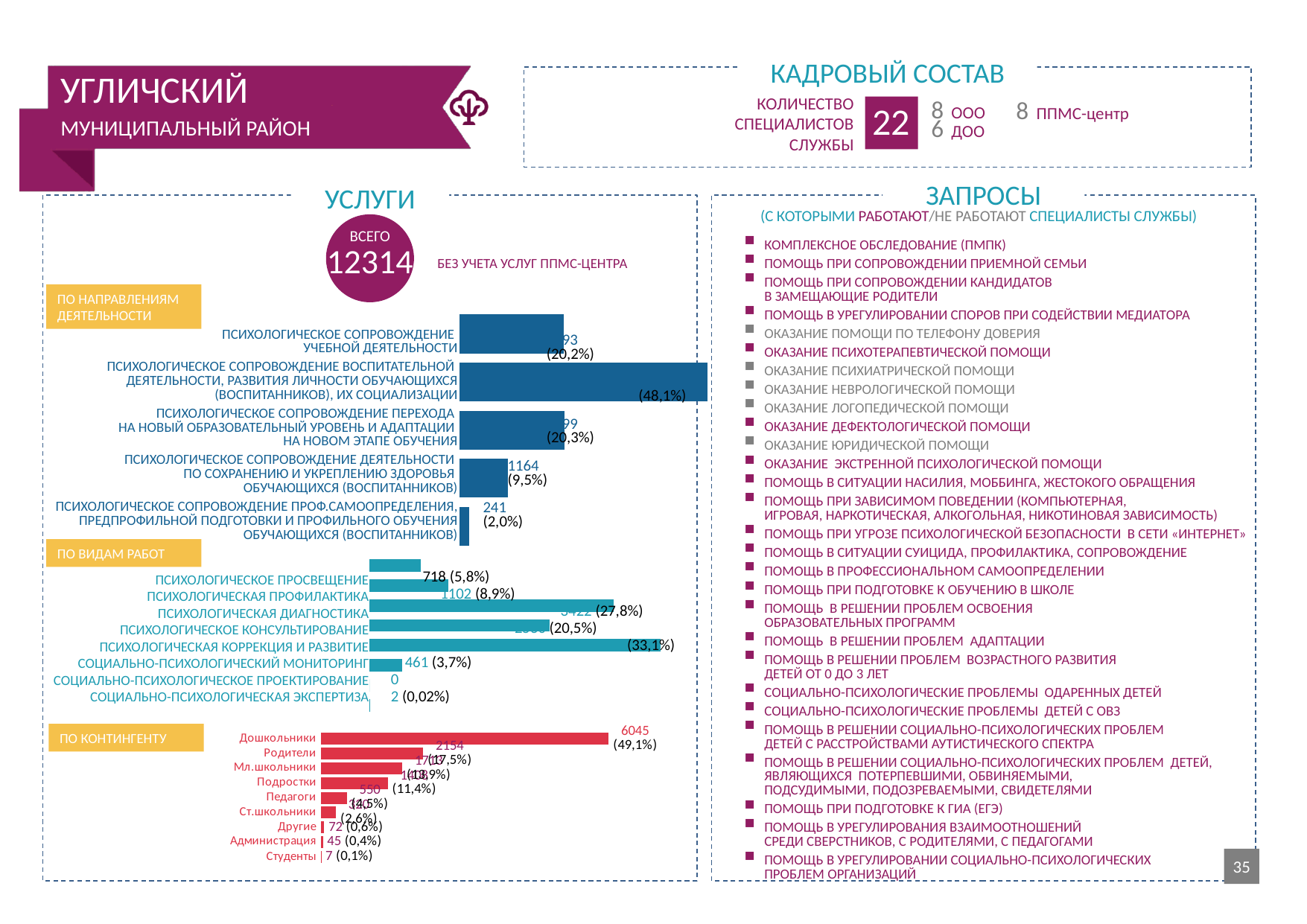
In the 'По видам работ' chart, what value is shown for 'Психологическое просвещение'? 718 (5,8%) In the 'По направлениям деятельности' chart, which category has the lowest value? Психологическое сопровождение проф.самоопределения, предпрофильной подготовки и профильного обучения обучающихся (воспитанников) In the 'По видам работ' chart, what is the difference between the values for 'Психологическая профилактика' and 'Психологическое просвещение'? 384 In the 'По видам работ' chart, which category has the highest value? Психологическая коррекция и развитие In the 'По направлениям деятельности' chart, what value is shown for 'Психологическое сопровождение деятельности по сохранению и укреплению здоровья обучающихся (воспитанников)'? 1164 (9,5%) In the 'По видам работ' chart, what value is shown for 'Социально-психологический мониторинг'? 461 (3,7%) How many categories does the 'По направлениям деятельности' chart show? 5 In the 'По контингенту' chart, which is larger: the value for 'Педагоги' or the value for 'Другие'? Педагоги How many categories does the 'По видам работ' chart show? 8 What type of chart is the 'По контингенту' chart? Bar chart In the 'По направлениям деятельности' chart, what percentage is shown for 'Психологическое сопровождение воспитательной деятельности, развития личности обучающихся (воспитанников), их социализации'? 48,1% In the 'По контингенту' chart, what value is shown for 'Дошкольники'? 6045 (49,1%)